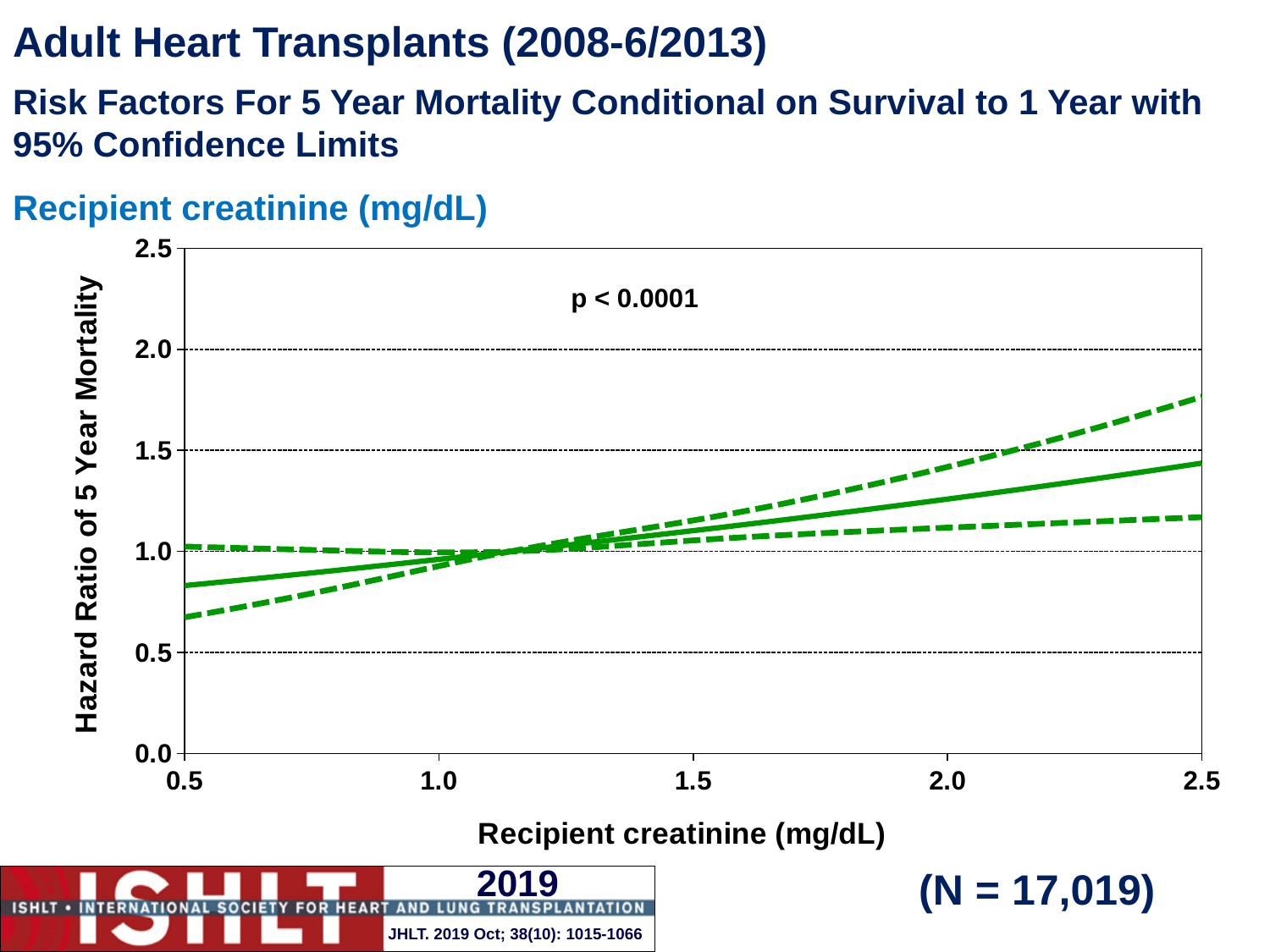
Is the hazard ratio on the solid line at a recipient creatinine of 0.5 mg/dL greater or less than 1.0? less What p-value is printed on the chart? p < 0.0001 Is the lower dashed confidence limit at a recipient creatinine of 0.5 mg/dL greater or less than 0.5? greater Is the hazard ratio on the solid line at a recipient creatinine of 2.0 mg/dL greater or less than 1.0? greater What kind of chart is shown on the slide? line chart What is the label of the x axis? Recipient creatinine (mg/dL) How many lines are plotted on the chart? 3 Does the solid hazard ratio line rise or fall as recipient creatinine increases from 0.5 to 2.5 mg/dL? rise